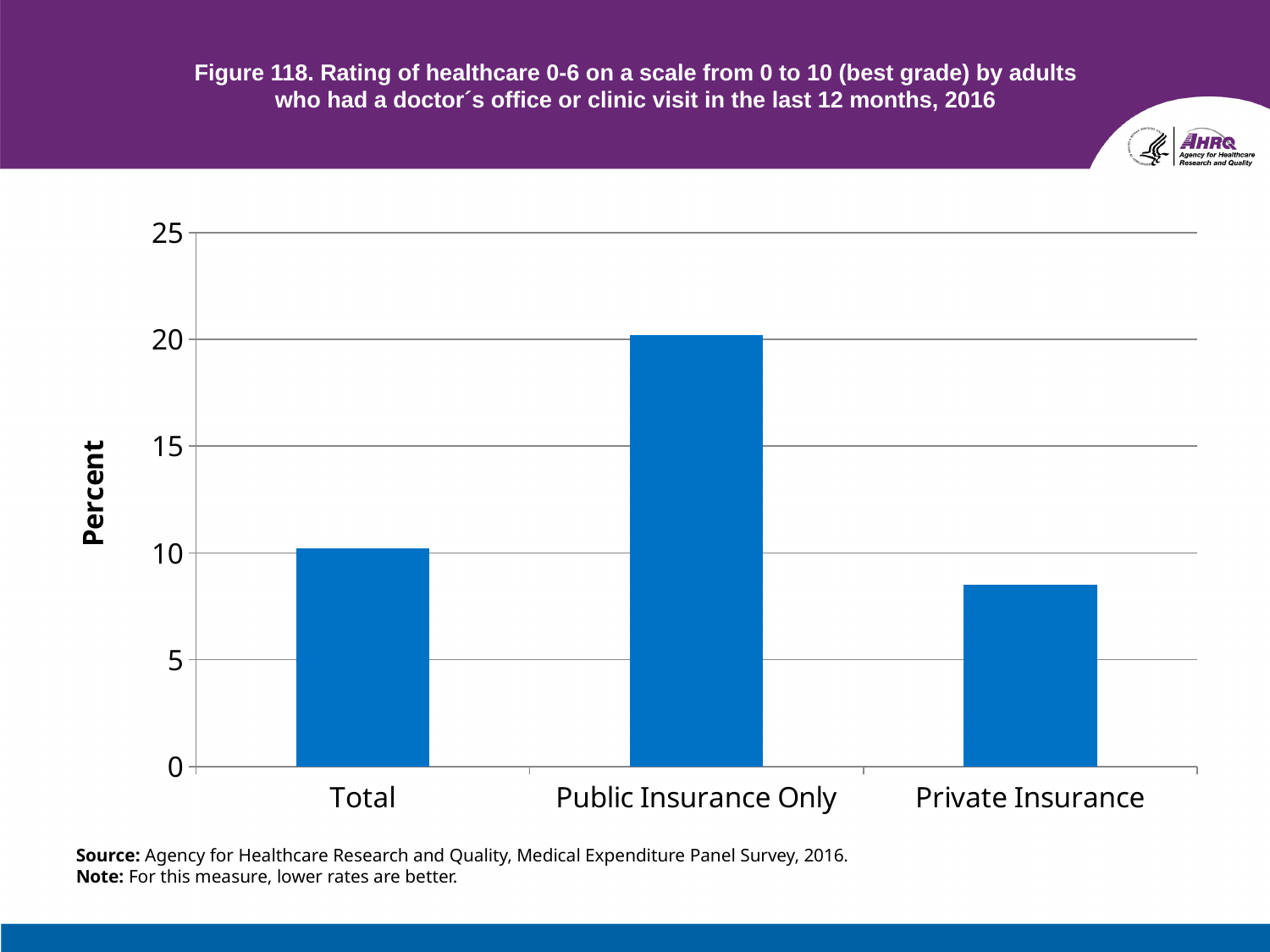
Which is larger, the value for Total or the value for Public Insurance Only? Public Insurance Only Is the value for Public Insurance Only greater or less than 15? greater Which category has the highest value in the chart? Public Insurance Only Which is larger, the value for Public Insurance Only or the value for Private Insurance? Public Insurance Only What kind of chart is shown on the slide? bar chart What is the maximum value shown on the y axis of the chart? 25 How many categories are shown on the x axis of the chart? 3 Is the value for Total greater or less than 15? less Is the value for Private Insurance greater or less than 5? greater What is the label on the y axis of the chart? Percent Which category has the lowest value in the chart? Private Insurance